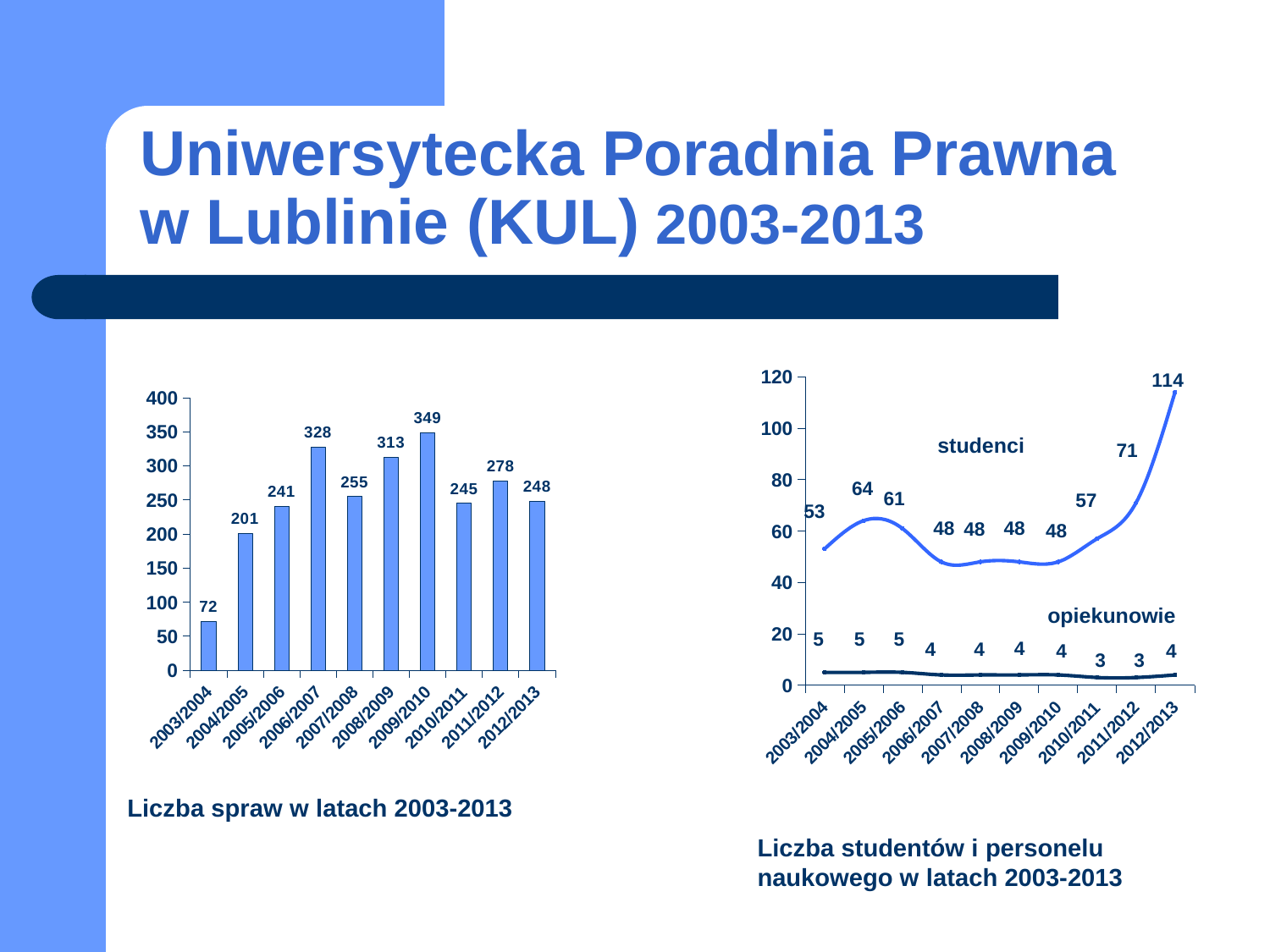
In the left chart (Liczba spraw w latach 2003-2013), which year has the lowest value? 2003/2004 What kind of chart is the left chart (Liczba spraw w latach 2003-2013)? Bar chart In the left chart (Liczba spraw w latach 2003-2013), how many years are shown on the x axis? 10 In the right chart (Liczba studentów i personelu naukowego), what is the difference between studenci and opiekunowie in 2003/2004? 48 In the right chart (Liczba studentów i personelu naukowego), how many series are plotted? 2 In the left chart (Liczba spraw w latach 2003-2013), what is the difference between the values for 2009/2010 and 2003/2004? 277 In the right chart (Liczba studentów i personelu naukowego), in which year is the studenci value highest? 2012/2013 In the left chart (Liczba spraw w latach 2003-2013), what is the value for 2006/2007? 328 What kind of chart is the right chart (Liczba studentów i personelu naukowego)? Line chart In the right chart (Liczba studentów i personelu naukowego), what is the value for studenci in 2012/2013? 114 In the left chart (Liczba spraw w latach 2003-2013), which year has the highest value? 2009/2010 In the right chart (Liczba studentów i personelu naukowego), what is the value for opiekunowie in 2010/2011? 3